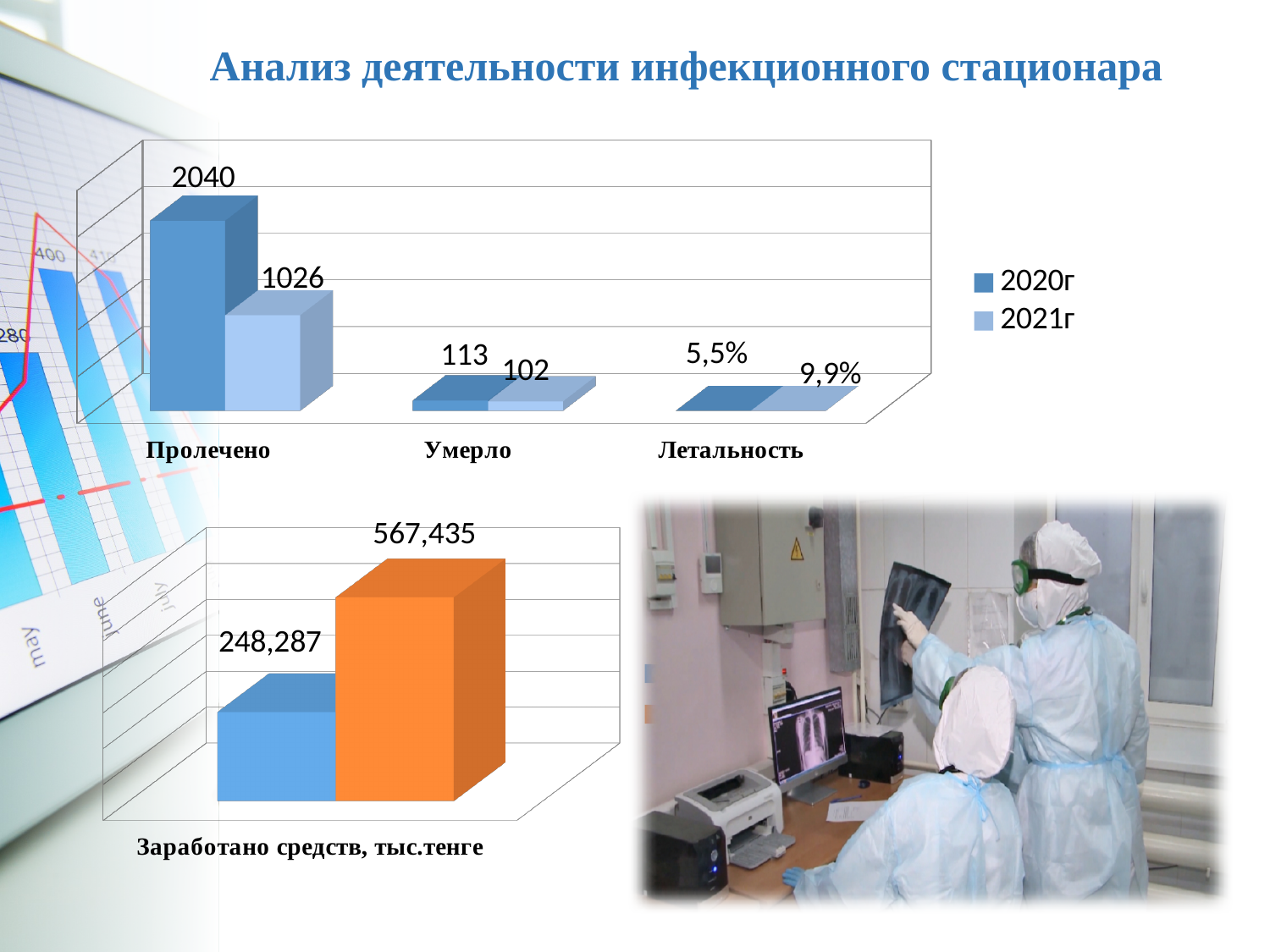
In the top chart, what is the value for Пролечено in 2020г? 2040 How many series does the legend of the top chart list? 2 How many categories are shown on the x axis of the top chart? 3 In the bottom chart titled Заработано средств, тыс.тенге, what is the value of the orange bar? 567,435 In the top chart, what is the value for Летальность in 2020г? 5,5% In the top chart, which year has the higher Летальность value, 2020г or 2021г? 2021г In the top chart, what is the difference between the 2020г and 2021г values for Пролечено? 1014 In the top chart, what is the value for Умерло in 2021г? 102 In the bottom chart titled Заработано средств, тыс.тенге, what is the value of the blue bar? 248,287 In the top chart, what is the difference between the 2020г and 2021г values for Умерло? 11 In the top chart, what is the value for Пролечено in 2021г? 1026 What kind of chart is the bottom chart titled Заработано средств, тыс.тенге? bar chart